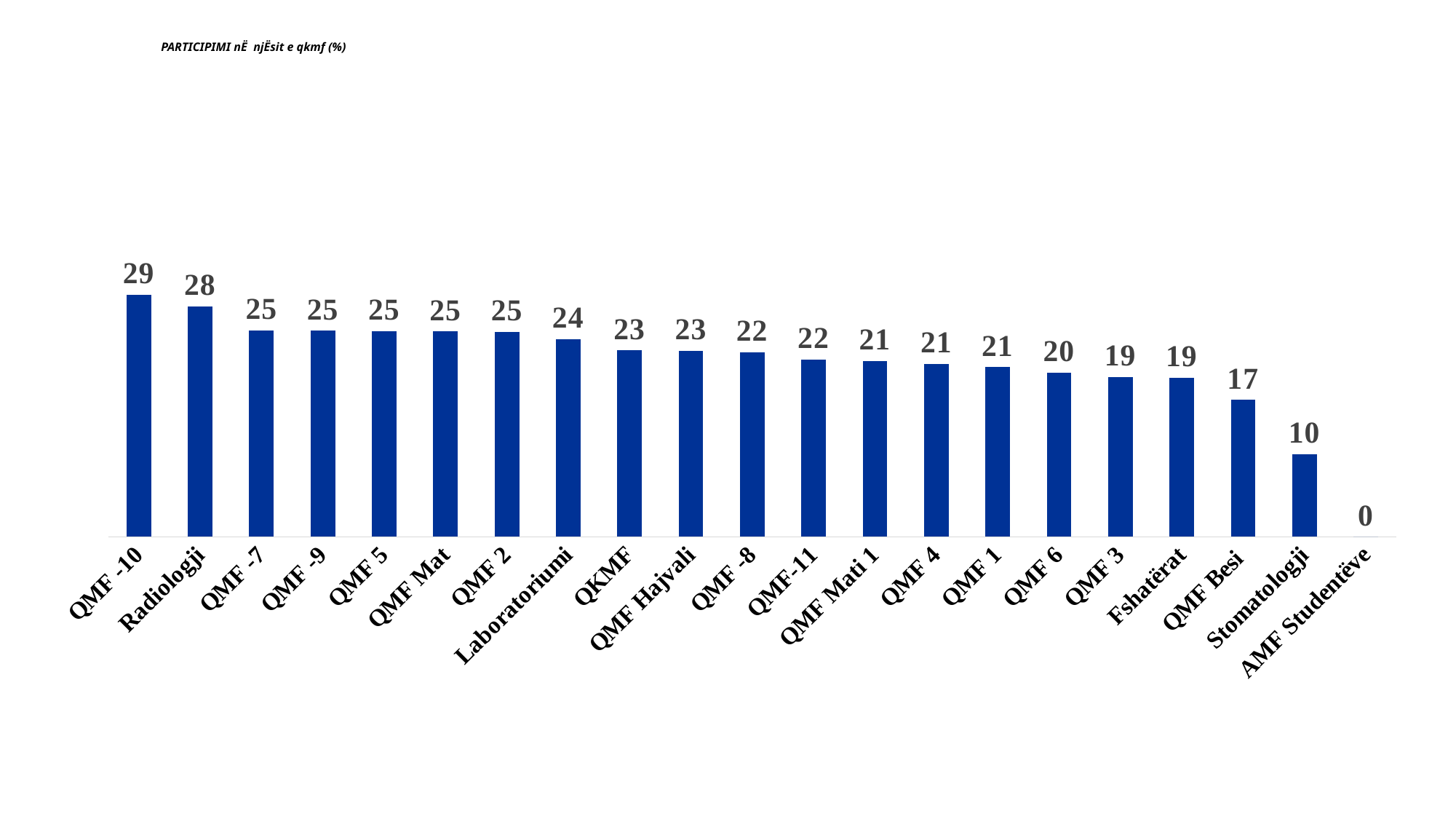
What is the value for Laboratoriumi? 24 Which is larger, the value for QKMF or the value for QMF 3? QKMF Do the values rise or fall from left to right along the x axis? Fall Which category has the lowest value? AMF Studentëve What kind of chart is shown on the slide? Bar chart What is the difference between the values for Radiologji and QMF 6? 8 What is the value for QMF Besi? 17 What is the difference between the values for QMF -10 and Stomatologji? 19 Which category has the highest value? QMF -10 What is the value for Stomatologji? 10 How many categories are shown in the chart? 21 What is the value for Radiologji? 28